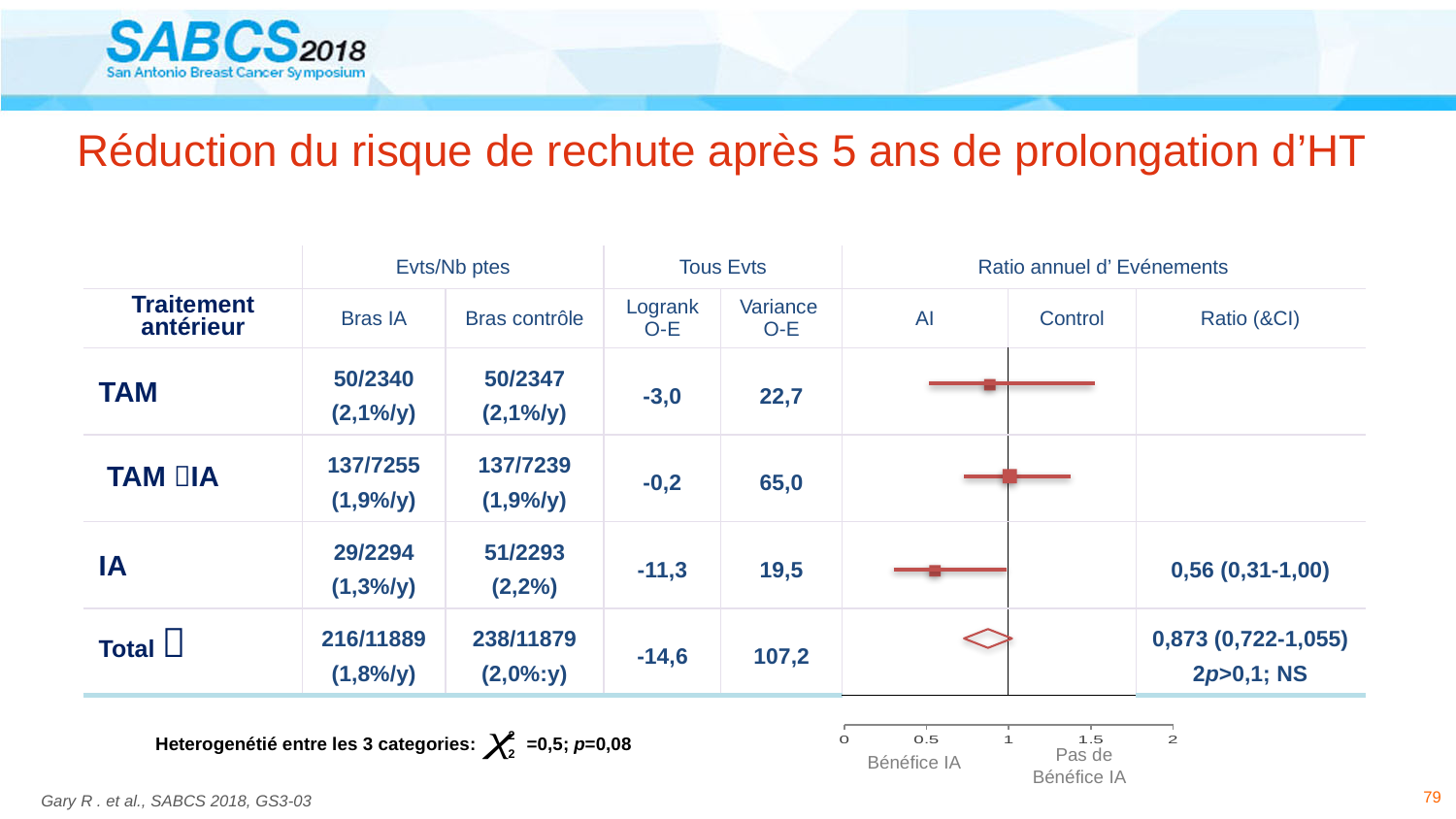
What is the Ratio (&CI) printed for the Total row? 0,873 (0,722-1,055) What is the Ratio (&CI) printed for the IA row? 0,56 (0,31-1,00) Which row has the highest Variance O-E value? Total How many rows (including Total) are plotted in the forest plot? 4 Is the ratio for the IA row greater or less than 1? less What kind of chart is shown in the 'Ratio annuel d' Evénements' section of the table? Forest plot In the IA row, which arm has more events: Bras IA (29/2294) or Bras contrôle (51/2293)? Bras contrôle What is the Variance O-E value for the Total row? 107,2 What is the p-value given for heterogeneity between the 3 categories? p=0,08 What is the difference between the Variance O-E of TAM→IA (65,0) and TAM (22,7)? 42,3 What is the Logrank O-E value for the IA row? -11,3 What label appears under the forest plot axis to the left of 1? Bénéfice IA